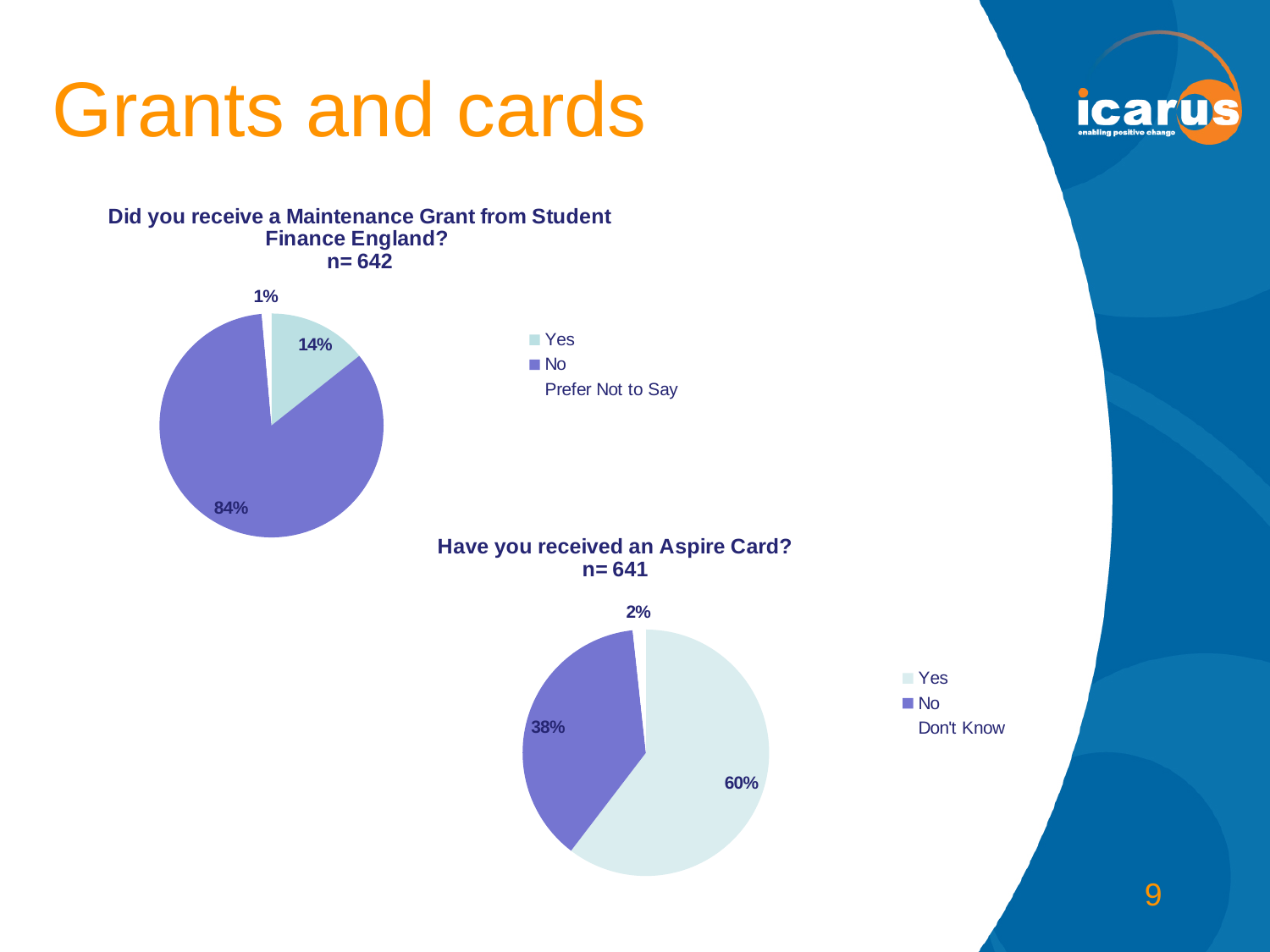
In the 'Did you receive a Maintenance Grant from Student Finance England?' chart, which response has the largest share? No In the 'Have you received an Aspire Card?' chart, what percentage answered Yes? 60% In the 'Have you received an Aspire Card?' chart, what percentage answered Don't Know? 2% In the 'Did you receive a Maintenance Grant from Student Finance England?' chart, what percentage answered No? 84% In the 'Have you received an Aspire Card?' chart, is the Yes share larger or the No share larger? Yes In the 'Have you received an Aspire Card?' chart, what percentage answered No? 38% In the 'Have you received an Aspire Card?' chart, which response has the smallest share? Don't Know In the 'Did you receive a Maintenance Grant from Student Finance England?' chart, what is the difference between the No and Yes shares? 70% In the 'Did you receive a Maintenance Grant from Student Finance England?' chart, what percentage chose Prefer Not to Say? 1% How many categories does the legend of the 'Did you receive a Maintenance Grant from Student Finance England?' chart list? 3 In the 'Did you receive a Maintenance Grant from Student Finance England?' chart, what percentage answered Yes? 14% What kind of chart is used for the 'Have you received an Aspire Card?' data? Pie chart